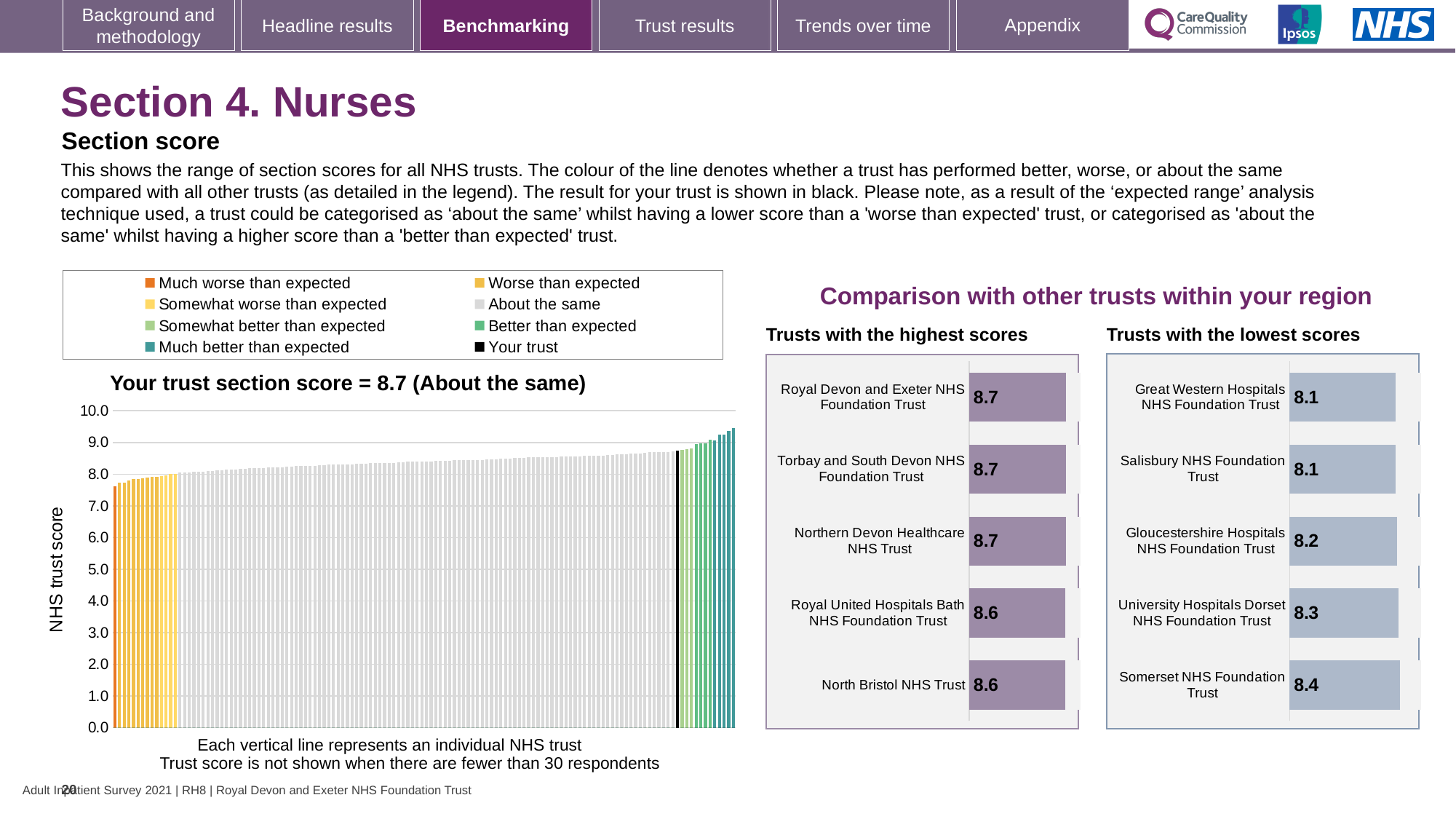
In the 'Trusts with the lowest scores' chart, what is the score for Gloucestershire Hospitals NHS Foundation Trust? 8.2 In the 'Trusts with the lowest scores' chart, which trust has the highest score? Somerset NHS Foundation Trust In the 'Trusts with the lowest scores' chart, what is the difference between the scores of Somerset NHS Foundation Trust and Great Western Hospitals NHS Foundation Trust? 0.3 What kind of chart is the main chart on the left of the slide? bar chart How many trusts are listed in the 'Trusts with the lowest scores' chart? 5 In the 'Trusts with the highest scores' chart, which has the larger score: Royal Devon and Exeter NHS Foundation Trust or North Bristol NHS Trust? Royal Devon and Exeter NHS Foundation Trust In the main chart on the left, is the value of the lowest-scoring trust greater or less than 8.0? less In the main chart on the left, do the trust scores rise or fall from left to right along the x axis? rise How many entries does the legend of the main chart on the left list? 8 In the 'Trusts with the highest scores' chart, what is the score for Northern Devon Healthcare NHS Trust? 8.7 In the 'Trusts with the highest scores' chart, what is the score for Royal United Hospitals Bath NHS Foundation Trust? 8.6 In the main chart on the left, what is the section score for your trust? 8.7